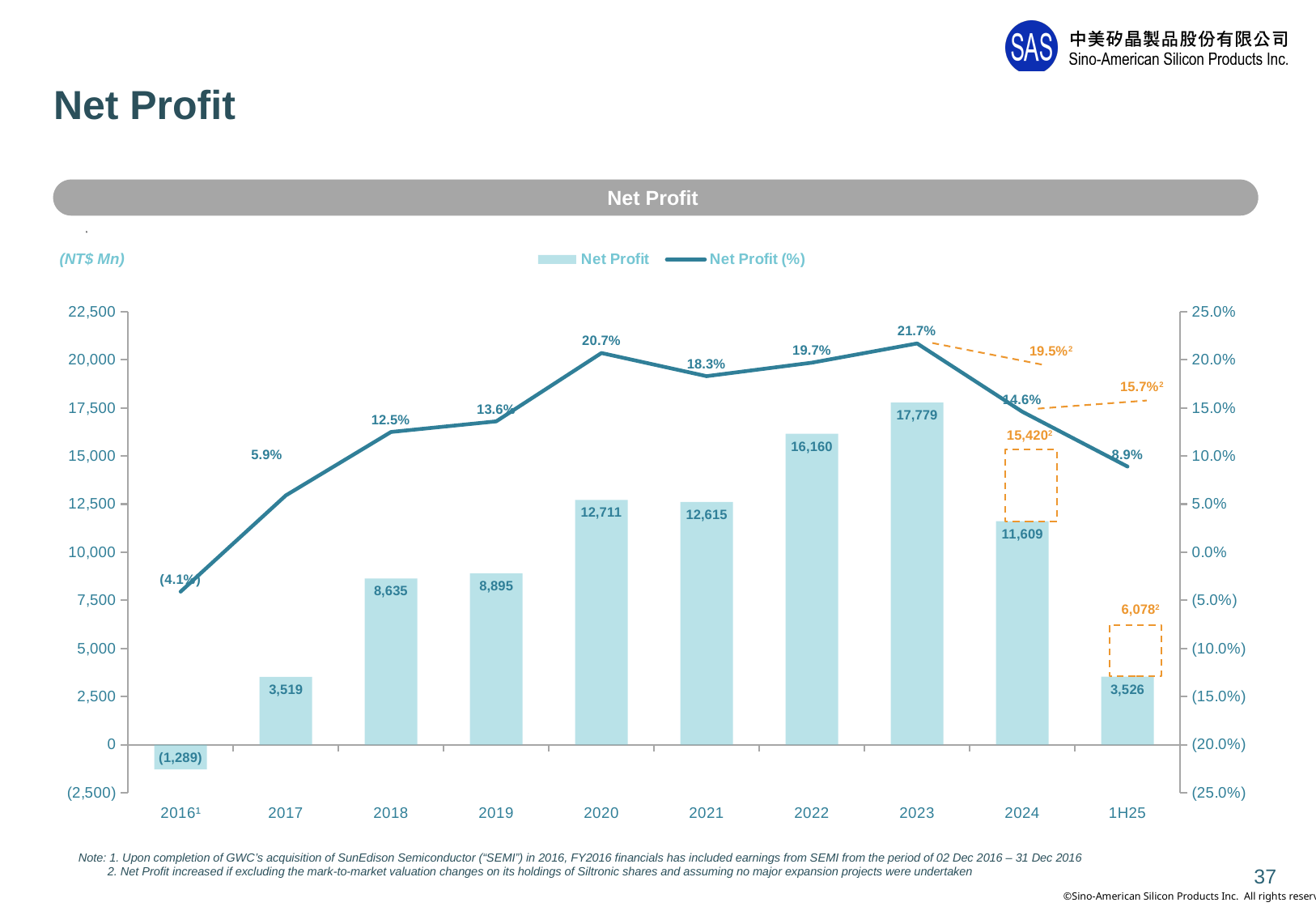
How many series does the legend list? 2 What is the difference between the Net Profit values for 2022 and 2024? 4,551 What is the Net Profit value for 1H25? 3,526 Which category has the lowest Net Profit value? 2016 Is the Net Profit value for 2019 greater or less than 10,000? less What is the Net Profit (%) for 2020? 20.7% What is the Net Profit (%) for 2023? 21.7% Which year has the highest Net Profit bar? 2023 How many categories are shown on the x axis? 10 What kind of chart is this? Combined bar and line chart Which is larger, the Net Profit for 2020 or for 2021? 2020 What is the Net Profit value for 2023? 17,779